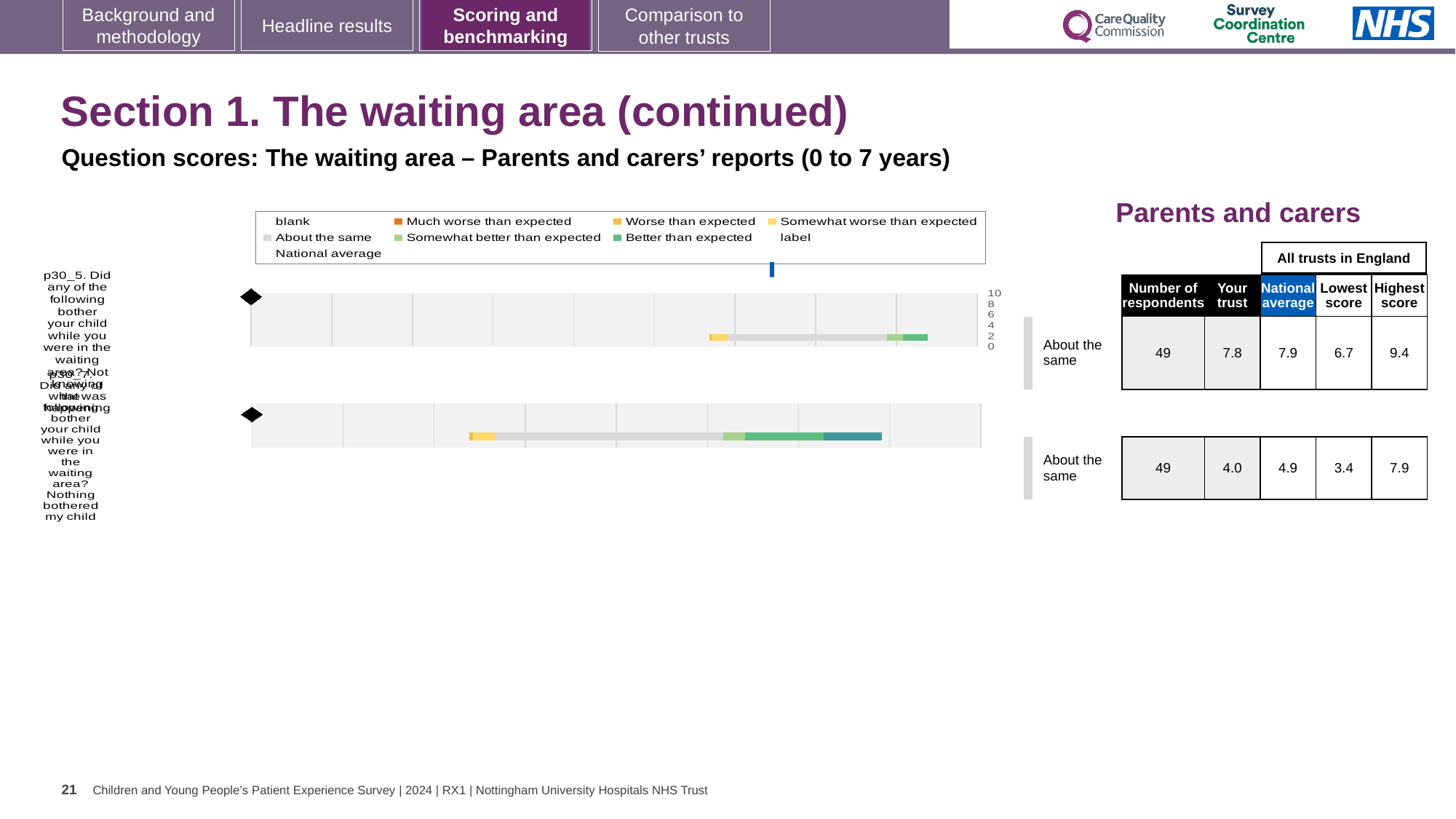
What is the highest score among all trusts in England for question p30_5? 9.4 What is the highest value shown on the chart's score axis? 10 In the chart legend, what colour represents 'Much worse than expected'? orange For question p30_5 (Not knowing what was happening), what is the 'Your trust' score shown in the table? 7.8 How many survey questions (bars) are plotted in the chart on this slide? 2 For question p30_7 (Nothing bothered my child), what is the 'Your trust' score? 4.0 For question p30_7, what is the difference between the national average (4.9) and the 'Your trust' score (4.0)? 0.9 What kind of chart is used to show the question scores on this slide? bar chart How many respondents answered question p30_7 (Nothing bothered my child)? 49 Which question has the higher 'Your trust' score, p30_5 or p30_7? p30_5 What benchmark category is shown for question p30_7 (Nothing bothered my child)? About the same For question p30_5, what is the national average score shown in the table? 7.9